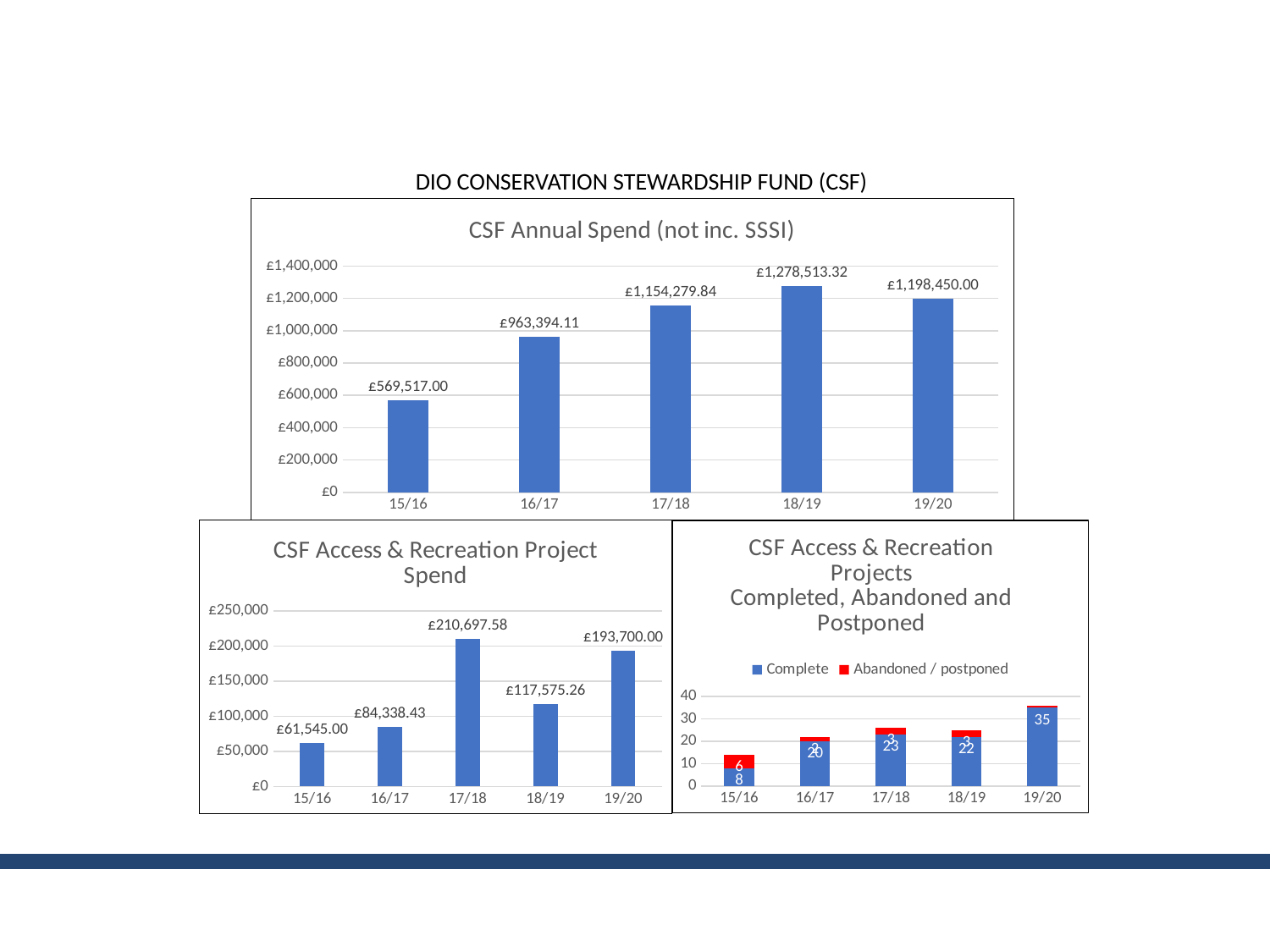
In the 'CSF Access & Recreation Project Spend' chart, what is the difference between the 19/20 spend and the 15/16 spend? £132,155.00 In the 'CSF Access & Recreation Projects Completed, Abandoned and Postponed' chart, how many projects were complete in 19/20? 35 In the 'CSF Access & Recreation Projects Completed, Abandoned and Postponed' chart, how many series does the legend list? 2 In the 'CSF Access & Recreation Project Spend' chart, what is the value for 17/18? £210,697.58 In the 'CSF Access & Recreation Projects Completed, Abandoned and Postponed' chart, what is the total height of the 15/16 stacked bar? 14 In the 'CSF Access & Recreation Project Spend' chart, which is larger, the spend for 16/17 or 18/19? 18/19 In the 'CSF Access & Recreation Project Spend' chart, which year has the highest spend? 17/18 In the 'CSF Annual Spend (not inc. SSSI)' chart, is the spend for 16/17 greater or less than £1,000,000? less In the 'CSF Annual Spend (not inc. SSSI)' chart, which year has the lowest spend? 15/16 In the 'CSF Annual Spend (not inc. SSSI)' chart, which year has the highest spend? 18/19 In the 'CSF Annual Spend (not inc. SSSI)' chart, how many years are shown on the x axis? 5 In the 'CSF Annual Spend (not inc. SSSI)' chart, what is the value for 18/19? £1,278,513.32